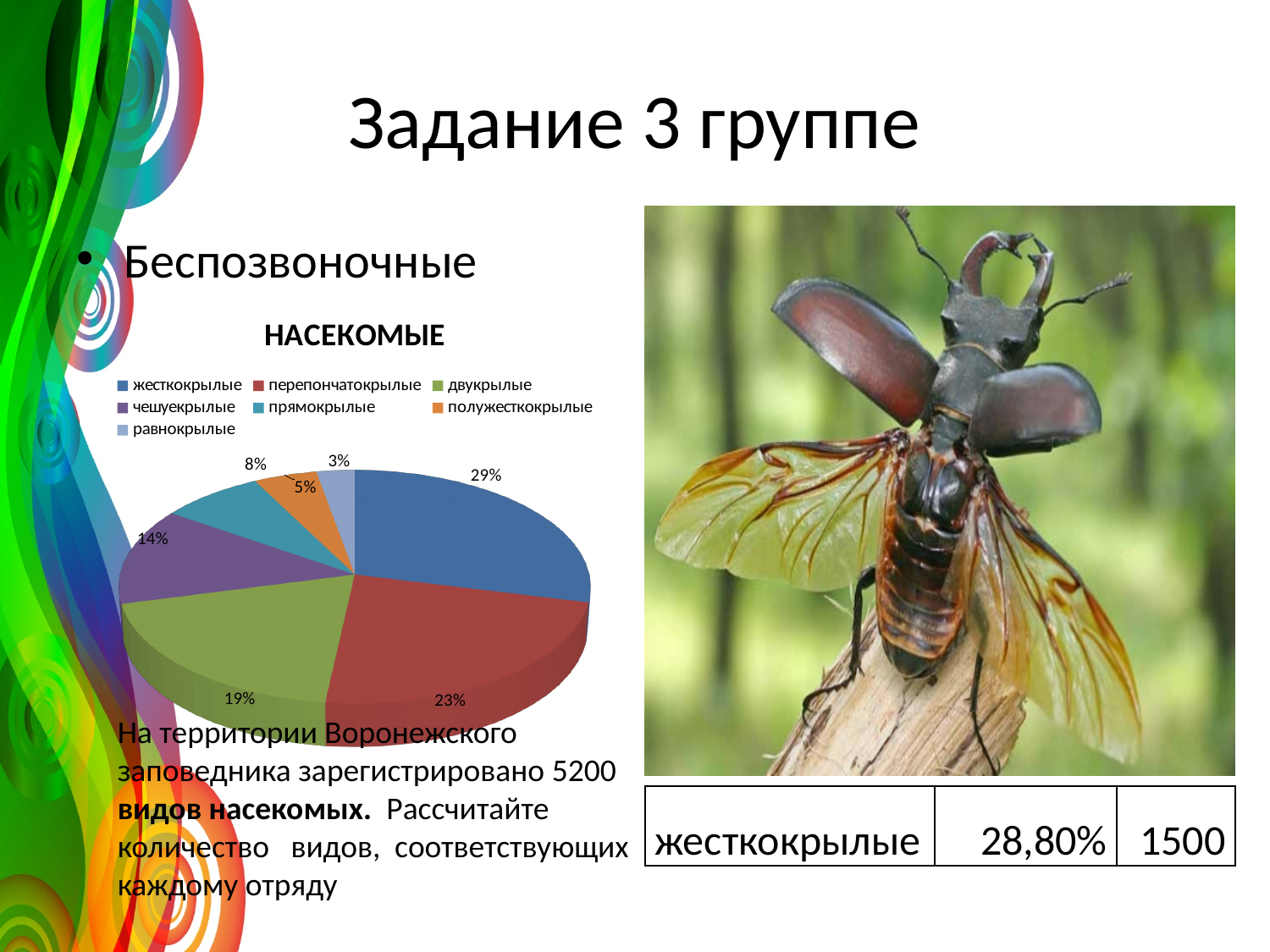
What type of chart is shown on the slide? pie chart Which category has the smallest slice of the pie? равнокрылые What is the title of the chart? НАСЕКОМЫЕ How many categories does the legend of the pie chart list? 7 What is the difference in percentage points between жесткокрылые and прямокрылые? 21 Which is larger, the slice for двукрылые or the slice for чешуекрылые? двукрылые What share of the pie does двукрылые have? 19% What share of the pie does перепончатокрылые have? 23% Which category has the largest slice of the pie? жесткокрылые What share of the pie does чешуекрылые have? 14%